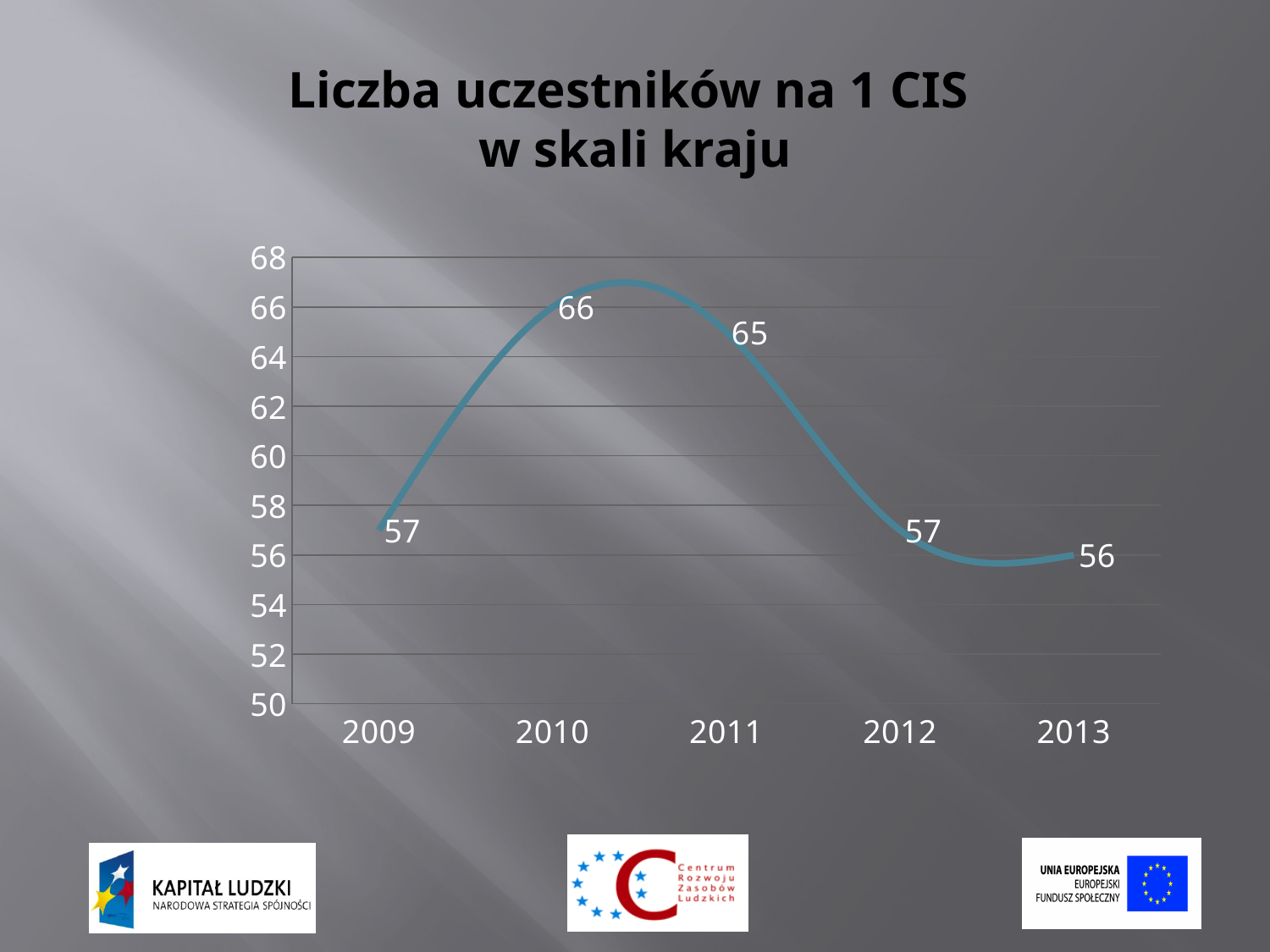
What is the value for 2011? 65 Which year has the lowest value? 2013 What is the value for 2013? 56 What is the value for 2010? 66 What is the difference between the values for 2010 and 2013? 10 Do the values rise or fall from 2011 to 2013? fall How many years are plotted on the chart? 5 Which is larger, the value for 2009 or the value for 2011? 2011 What kind of chart is shown on the slide? line chart What is the difference between the values for 2011 and 2012? 8 Is the value for 2012 greater or less than 60? less Which year has the highest value? 2010